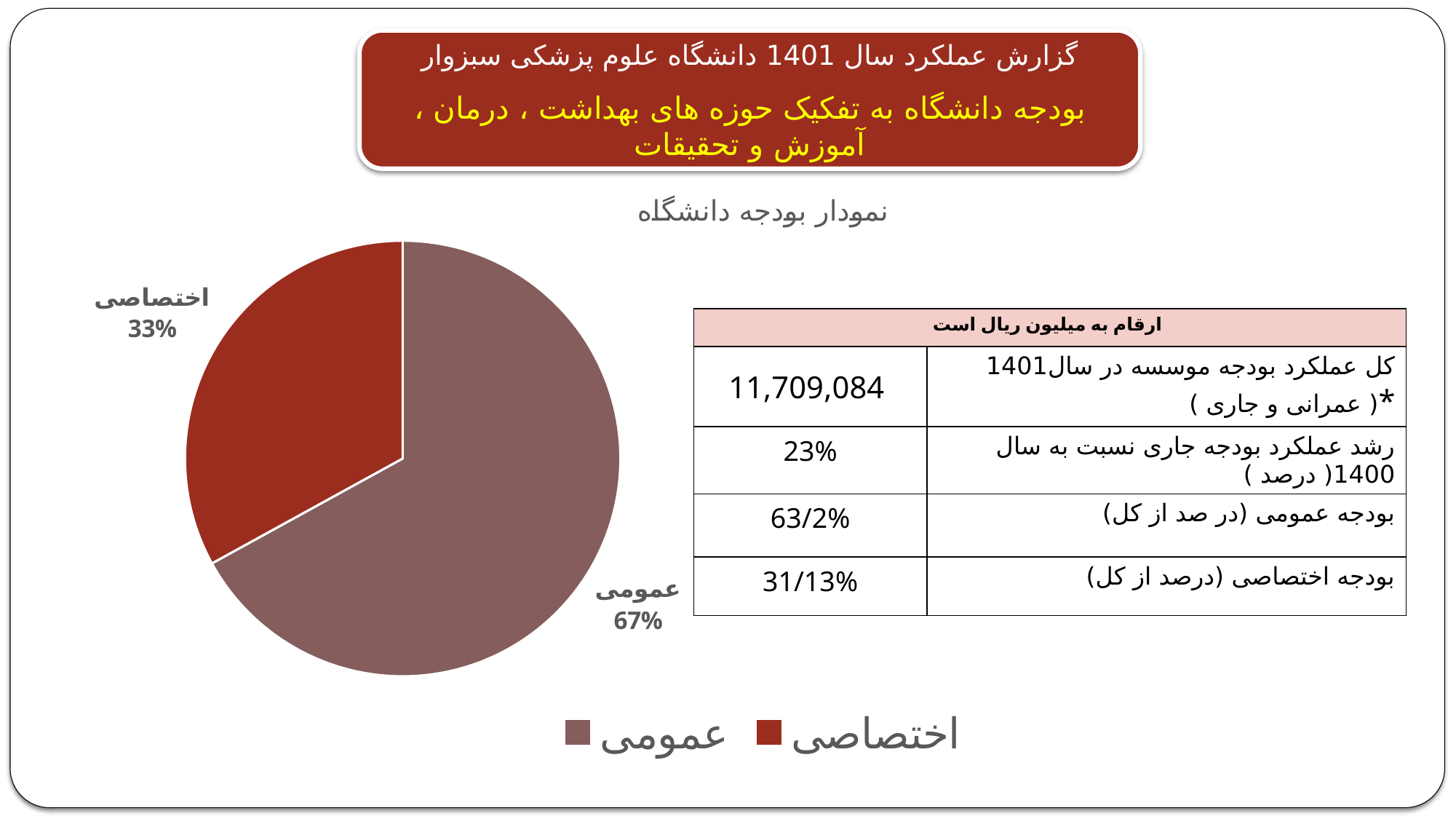
Which slice of the pie is the largest? عمومی How many entries does the chart legend list? 2 What share of the pie does the عمومی slice represent? 67% Which is larger, the عمومی slice or the اختصاصی slice? عمومی What is the title of the chart? نمودار بودجه دانشگاه Which legend entry is shown in the darker red colour? اختصاصی What is the difference in percentage points between the عمومی and اختصاصی slices? 34% What kind of chart is shown on the slide? pie chart How many slices does the pie chart have? 2 Which slice of the pie is the smallest? اختصاصی What share of the pie does the اختصاصی slice represent? 33%